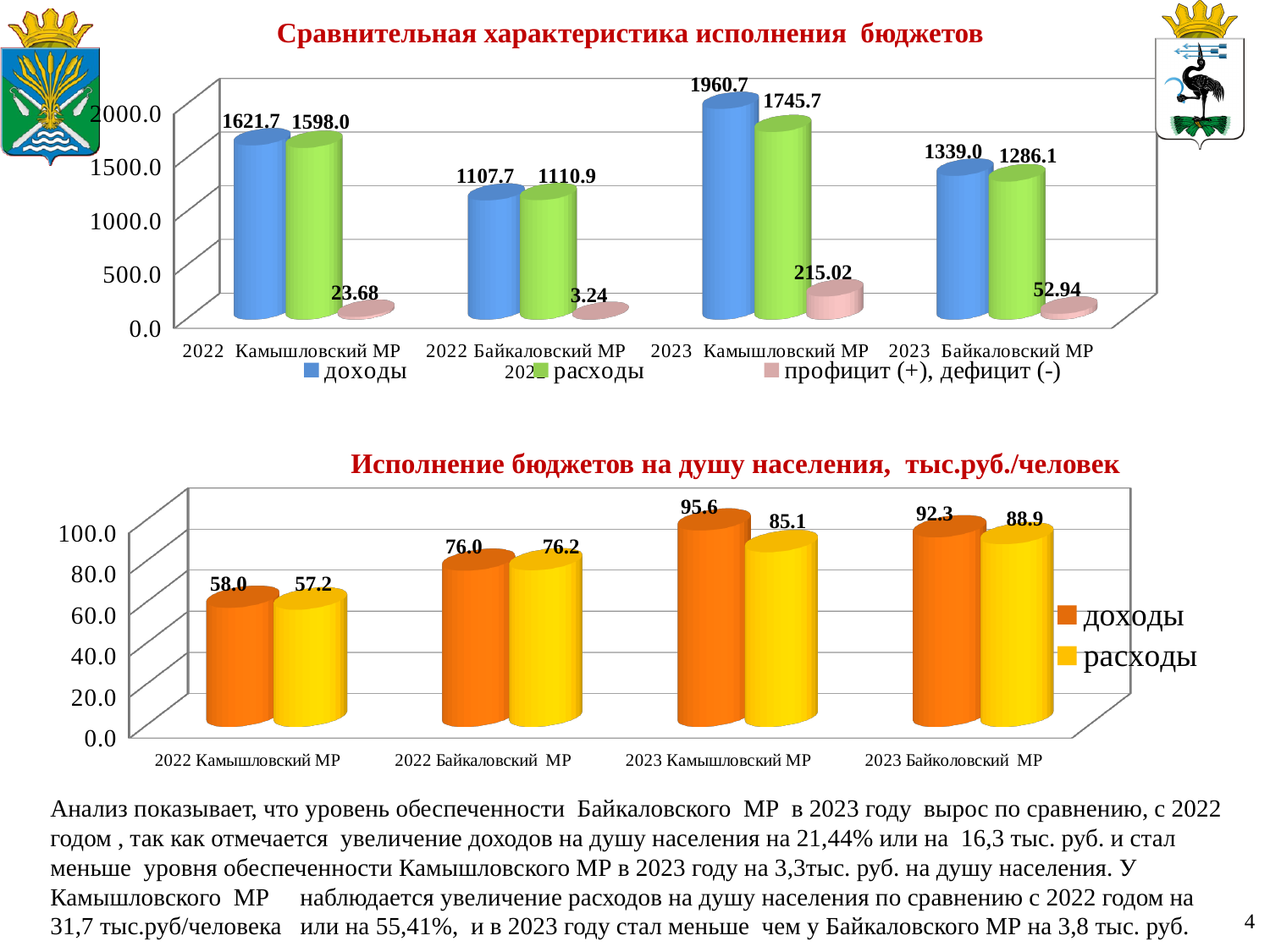
In the top chart 'Сравнительная характеристика исполнения бюджетов', what is the value of доходы for 2023 Камышловский МР? 1960.7 In the top chart 'Сравнительная характеристика исполнения бюджетов', which category has the highest расходы value? 2023 Камышловский МР In the bottom chart 'Исполнение бюджетов на душу населения', how many categories are shown on the x axis? 4 In the top chart 'Сравнительная характеристика исполнения бюджетов', what is the value of профицит (+), дефицит (-) for 2022 Байкаловский МР? 3.24 In the top chart 'Сравнительная характеристика исполнения бюджетов', what is the difference between доходы and расходы for 2023 Байкаловский МР? 52.9 In the top chart 'Сравнительная характеристика исполнения бюджетов', which category has the lowest доходы value? 2022 Байкаловский МР In the bottom chart 'Исполнение бюджетов на душу населения', what is the difference between доходы and расходы for 2023 Камышловский МР? 10.5 In the bottom chart 'Исполнение бюджетов на душу населения', what is the value of доходы for 2022 Байкаловский МР? 76.0 In the top chart 'Сравнительная характеристика исполнения бюджетов', how many series does the legend list? 3 What type of chart is the bottom chart 'Исполнение бюджетов на душу населения'? Bar chart In the bottom chart 'Исполнение бюджетов на душу населения', what is the value of расходы for 2023 Камышловский МР? 85.1 In the bottom chart 'Исполнение бюджетов на душу населения', which category has the highest доходы value? 2023 Камышловский МР